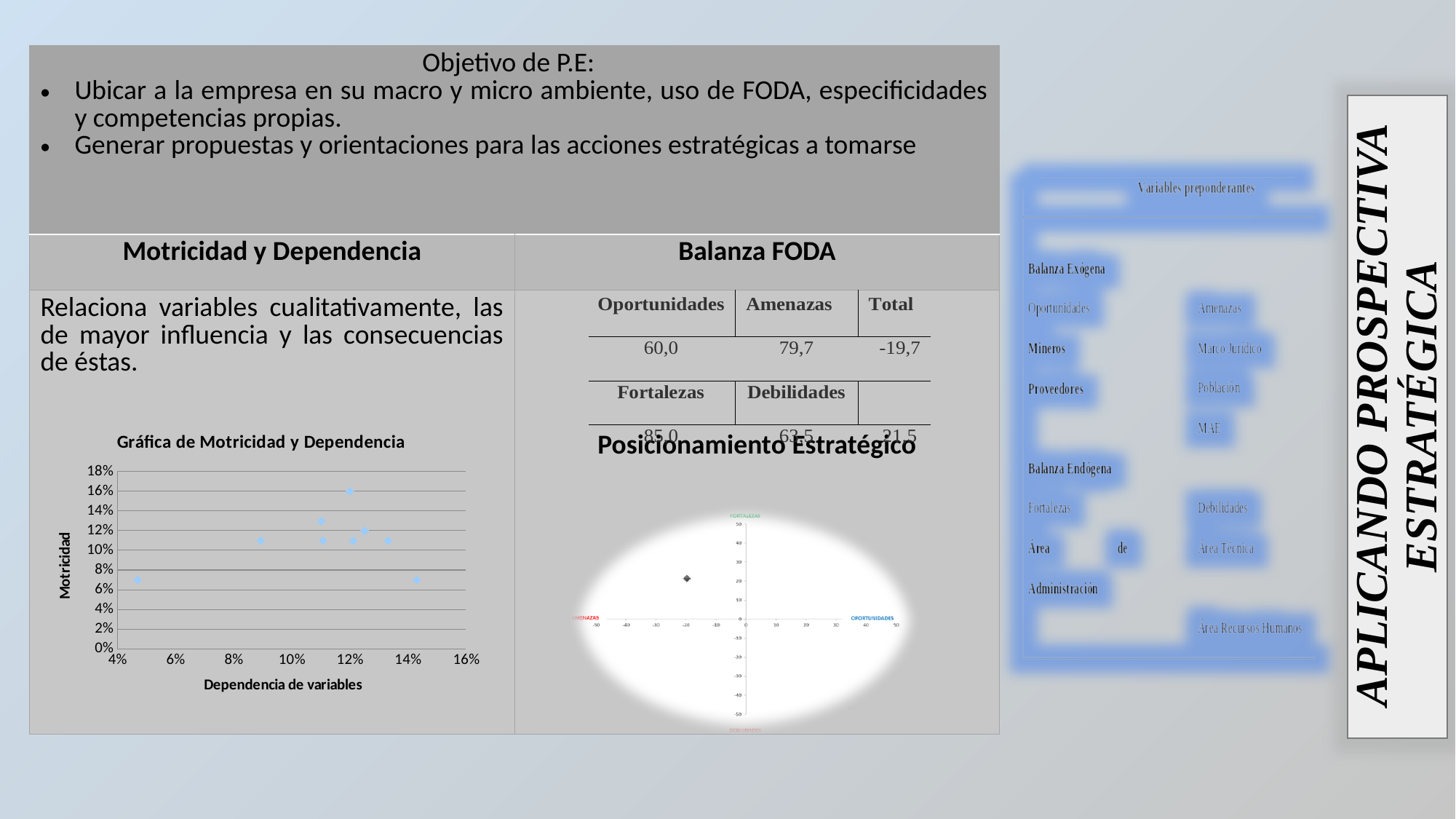
In the 'Gráfica de Motricidad y Dependencia', is the lowest Motricidad value plotted greater or less than 8%? less In the 'Gráfica de Motricidad y Dependencia', what is the title of the vertical axis? Motricidad How many data points are plotted in the 'Posicionamiento Estratégico' chart? 1 In the 'Posicionamiento Estratégico' chart, is the vertical value of the plotted point greater or less than 30? less What kind of chart is the 'Gráfica de Motricidad y Dependencia'? scatter chart How many data points are plotted in the 'Gráfica de Motricidad y Dependencia'? 9 In the 'Gráfica de Motricidad y Dependencia', is the highest Motricidad value plotted greater or less than 14%? greater In the 'Gráfica de Motricidad y Dependencia', what is the title of the horizontal axis? Dependencia de variables What kind of chart is shown under 'Posicionamiento Estratégico'? scatter chart